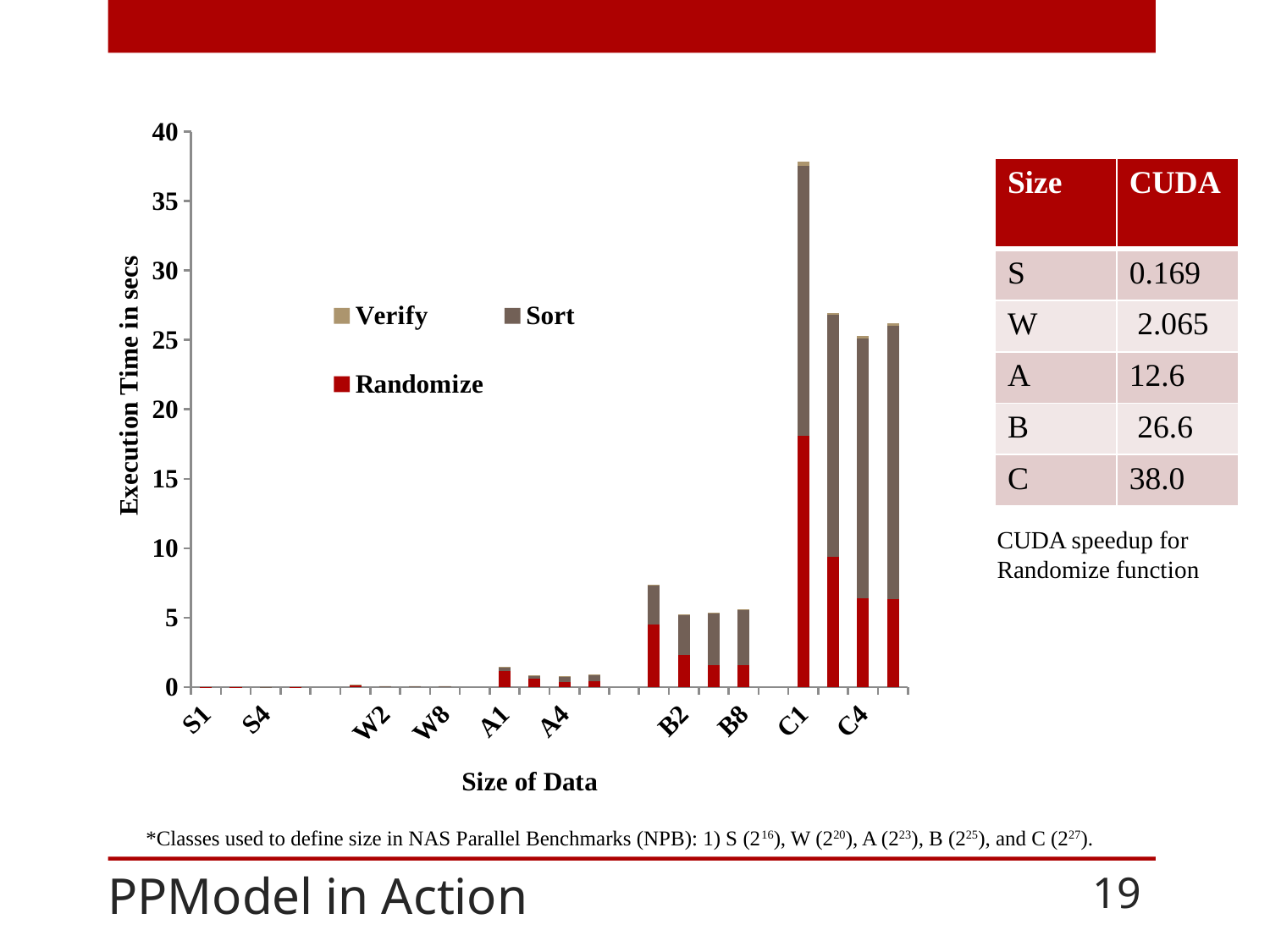
What kind of chart is shown on the slide? Stacked bar chart Which data size has the tallest bar in the chart? C1 What is the title of the chart's vertical axis? Execution Time in secs Is the total execution time for B8 greater or less than 10 secs? less Do the execution times generally rise or fall as the size of data increases from S to C along the x axis? Rise Is the total execution time for C1 greater or less than 35 secs? greater Which has the larger total execution time, B8 or A1? B8 Which has the larger total execution time, C1 or C4? C1 How many series does the chart's legend list? 3 Is the total execution time for A1 greater or less than 5 secs? less